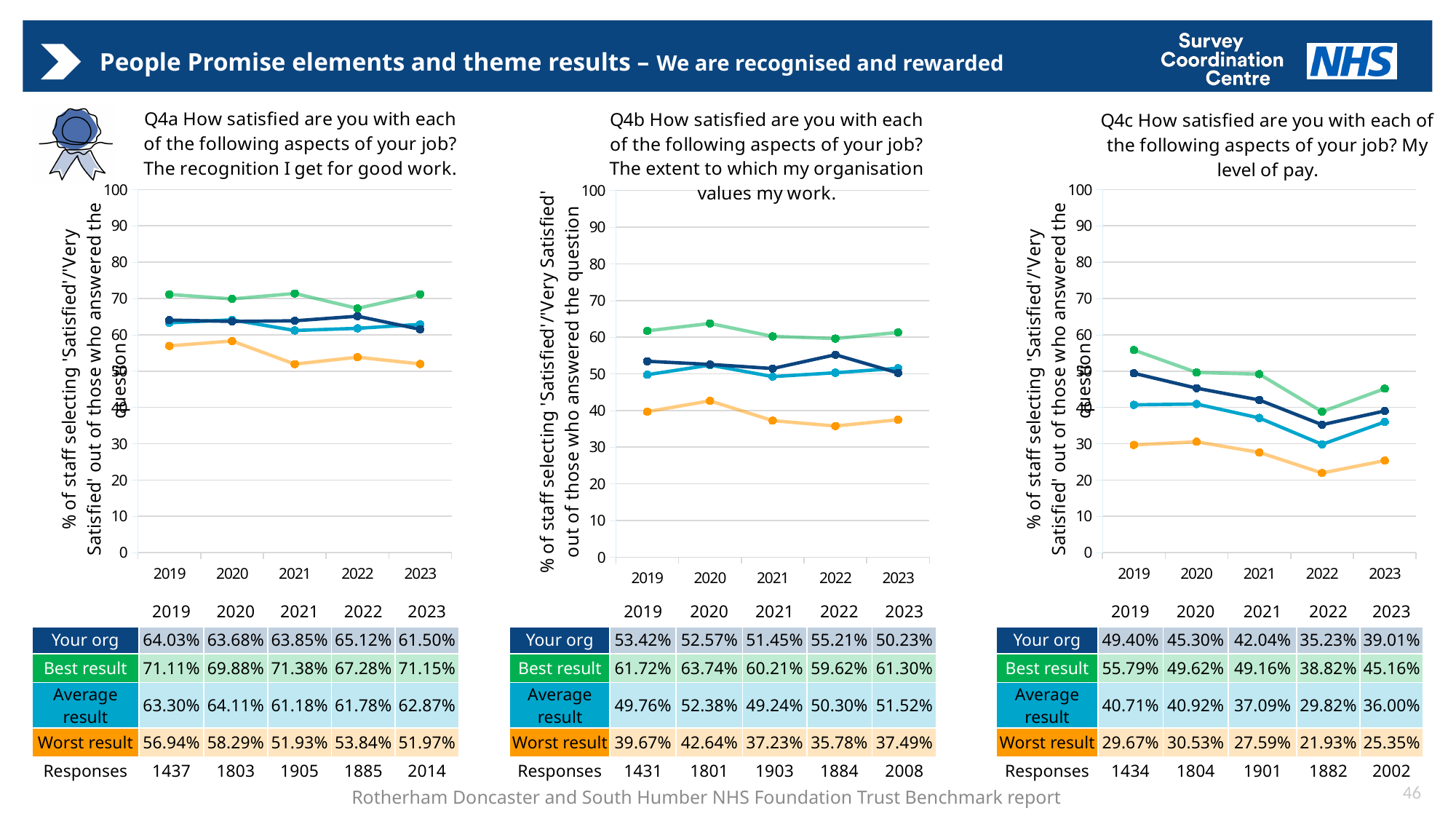
In the Q4b chart (The extent to which my organisation values my work), which year has the highest 'Best result' value? 2020 How many years are plotted on the x axis of the Q4a chart (The recognition I get for good work)? 5 In the Q4c chart (My level of pay), what is the difference between the 'Your org' values for 2019 and 2023? 10.39% In the Q4b chart (The extent to which my organisation values my work), what is the 'Average result' value for 2023? 51.52% What kind of chart is used for Q4c (My level of pay)? line chart In the Q4b chart (The extent to which my organisation values my work), is the 'Your org' value for 2022 larger or smaller than the 'Average result' value for 2022? larger In the Q4a chart (The recognition I get for good work), what is the 'Your org' value for 2022? 65.12% In the Q4c chart (My level of pay), what is the 'Worst result' value for 2022? 21.93% How many series are plotted in the Q4b chart (The extent to which my organisation values my work)? 4 In the Q4c chart (My level of pay), which year has the lowest 'Your org' value? 2022 In the Q4c chart (My level of pay), is the 'Best result' value for 2022 greater or less than 40? less In the Q4a chart (The recognition I get for good work), what is the difference between the 'Best result' and 'Worst result' values for 2023? 19.18%